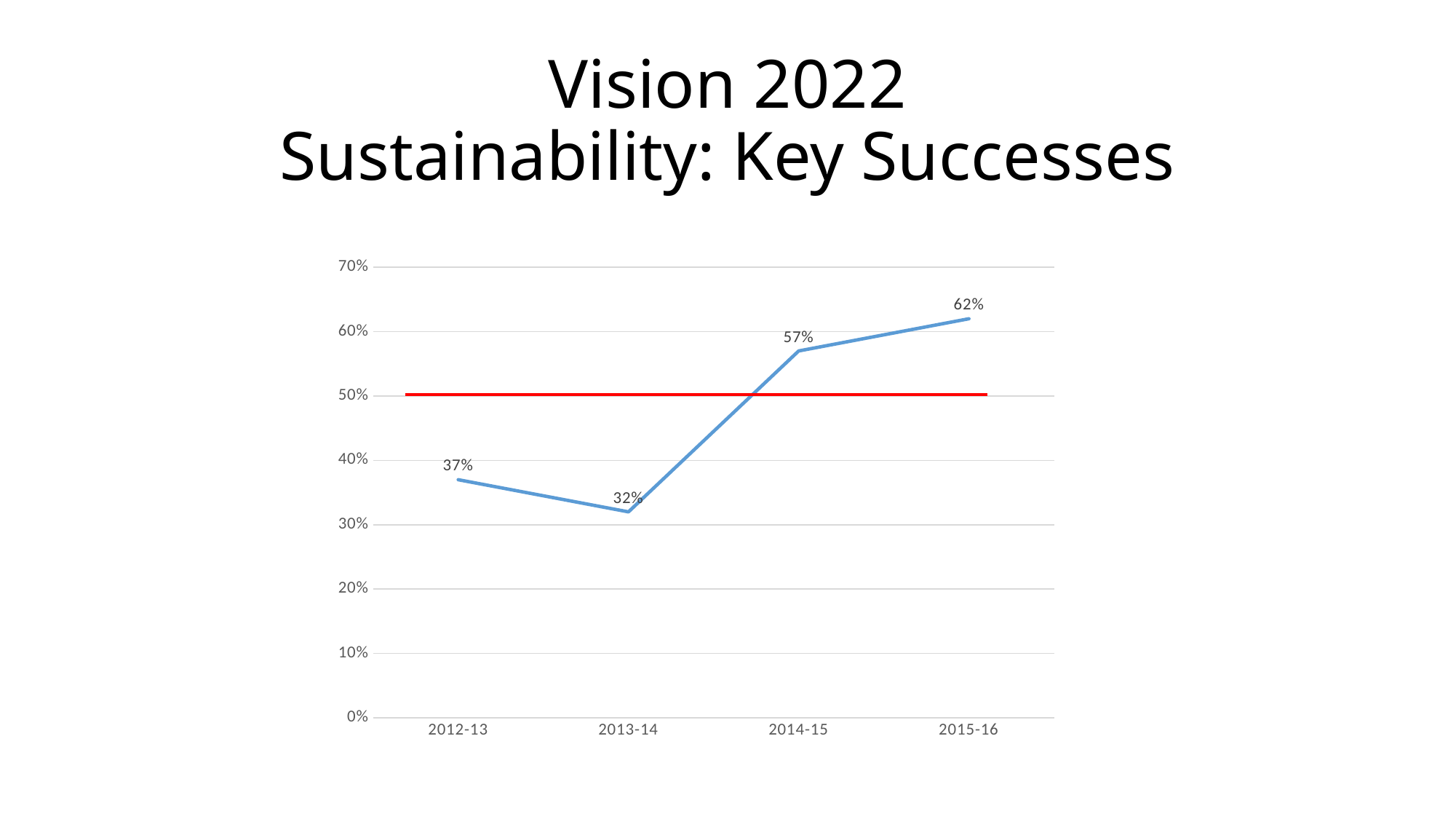
What is the value for 2014-15? 57% Which year has the highest value? 2015-16 What is the value for 2012-13? 37% What is the value for 2013-14? 32% What is the difference between the values for 2015-16 and 2012-13? 25% How many years are plotted on the x axis? 4 Which year has the lowest value? 2013-14 Is the value for 2014-15 greater or less than 50%? greater What is the value for 2015-16? 62% What is the difference between the values for 2014-15 and 2013-14? 25% Which is larger, the value for 2012-13 or the value for 2013-14? 2012-13 What kind of chart is shown on the slide? line chart